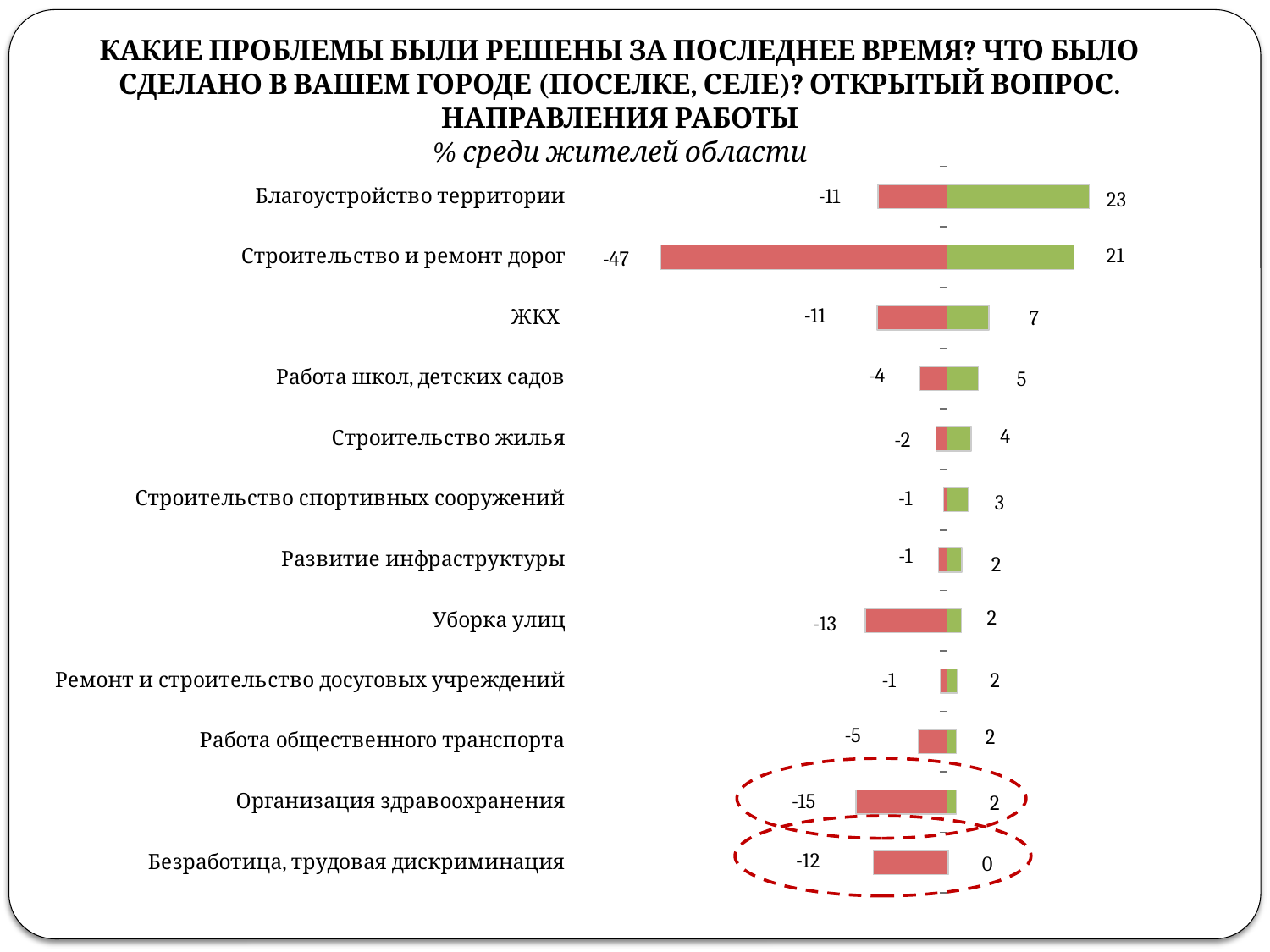
Which category has the largest green (positive) value? Благоустройство территории What is the green value for ЖКХ? 7 Which two categories are circled with a dashed red outline? Организация здравоохранения and Безработица, трудовая дискриминация What is the green value for Безработица, трудовая дискриминация? 0 What is the green (positive) value for Благоустройство территории? 23 How many categories are shown in the chart? 12 What is the difference between the green values for Благоустройство территории and Строительство и ремонт дорог? 2 What is the red (negative) value for Строительство и ремонт дорог? -47 What kind of chart is shown on the slide? Bar chart What is the red value for Уборка улиц? -13 Which category has the largest red (negative) bar? Строительство и ремонт дорог Which has a larger red bar: Организация здравоохранения or Работа общественного транспорта? Организация здравоохранения